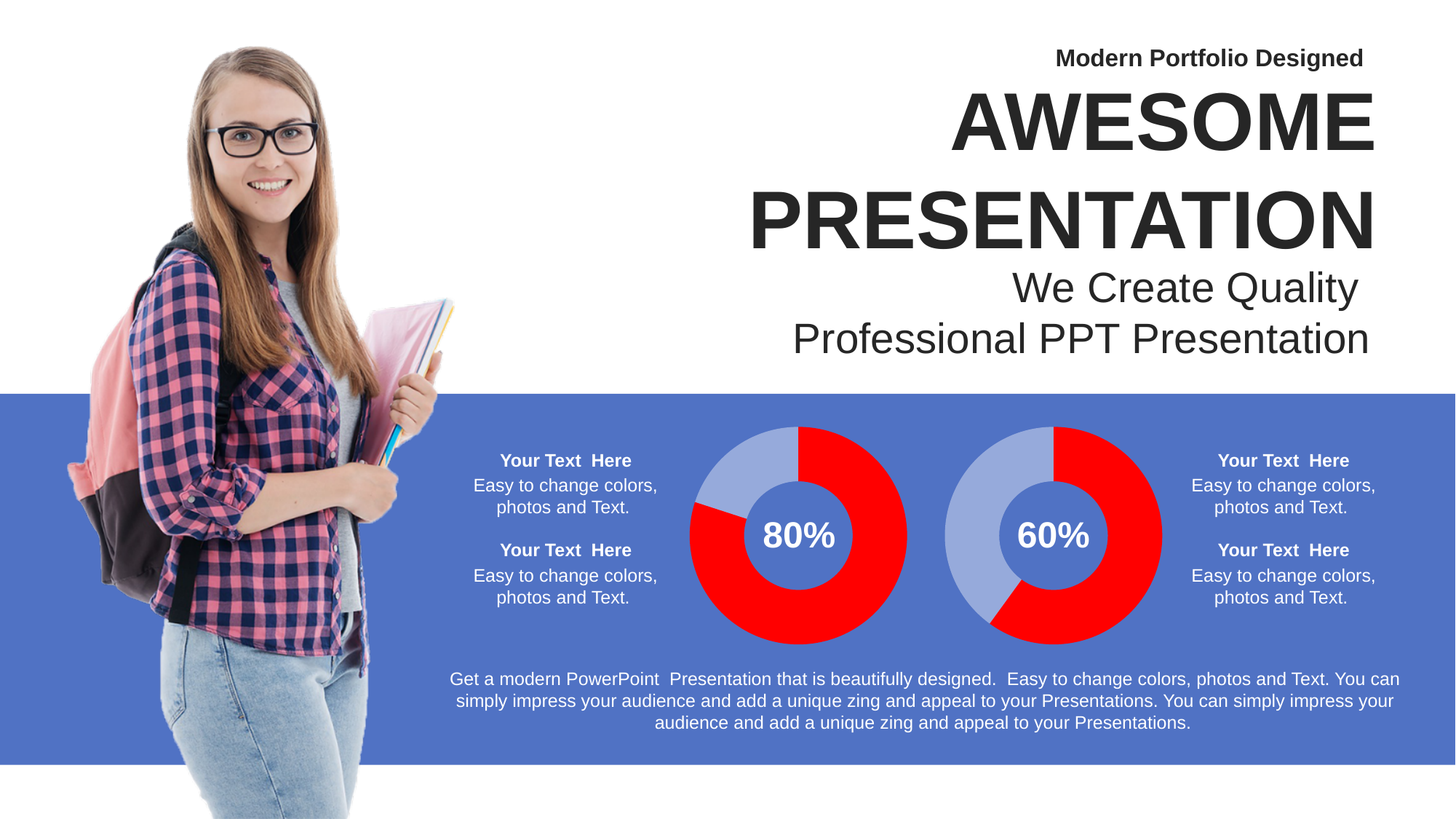
What value is shown in the centre of the right donut chart? 60% In the right donut chart, what share of the ring is the light blue portion? 40% What colour is the filled (highlighted) portion of each donut chart? red Is the value in the right donut chart greater or less than 50%? greater In the left donut chart, what share of the ring is filled in red? 80% Which donut chart shows the smaller percentage, the left one or the right one? the right one What value is shown in the centre of the left donut chart? 80% What kind of chart is used on the slide to show the 80% and 60% values? donut chart Which donut chart shows the larger percentage, the left one or the right one? the left one What is the difference between the percentage in the left donut chart and the percentage in the right donut chart? 20% How many donut charts are on the slide? 2 In the right donut chart, what share of the ring is filled in red? 60%